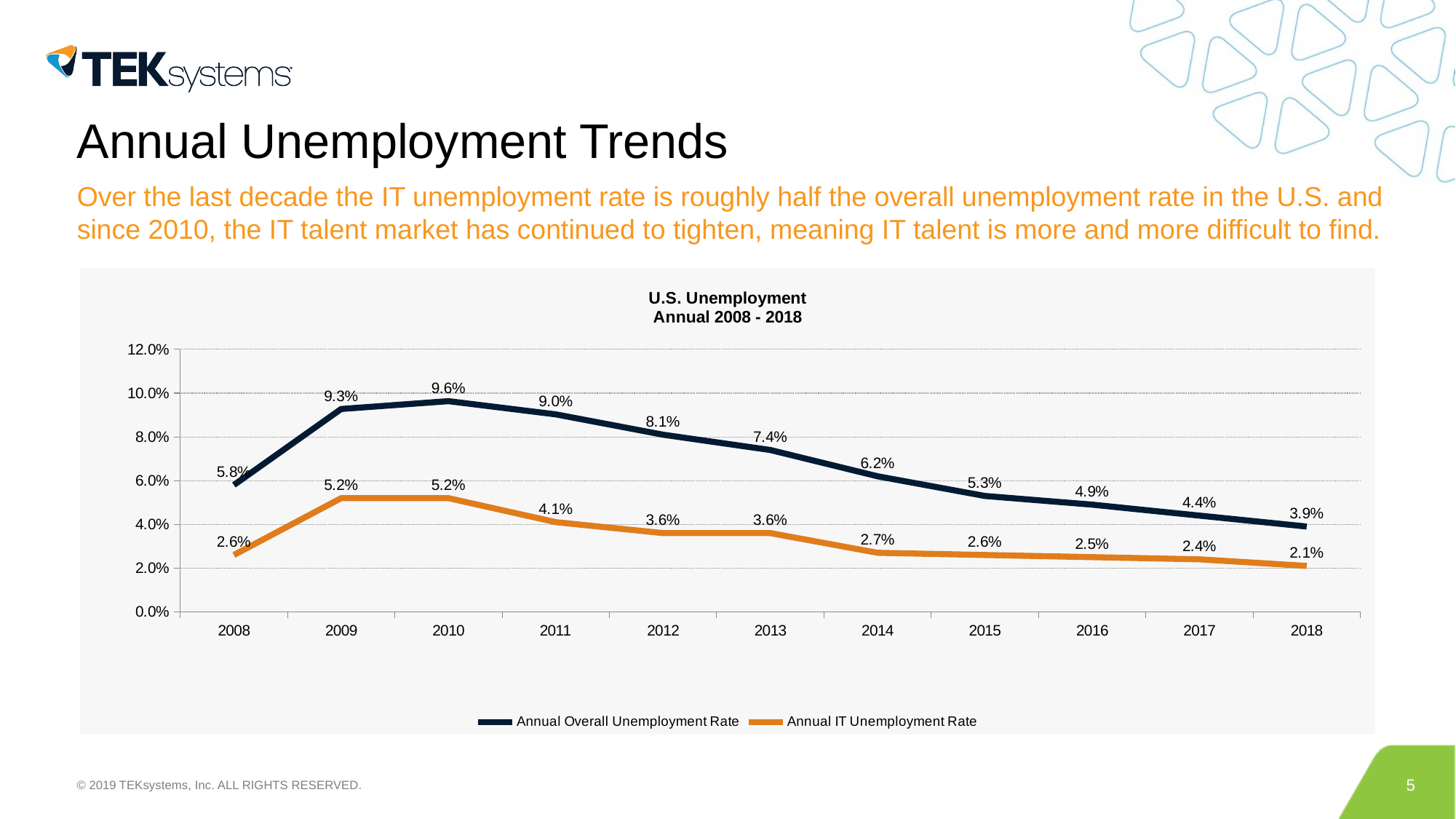
How many years are shown on the x axis of the chart? 11 Which was higher in 2009: the Annual Overall Unemployment Rate or the Annual IT Unemployment Rate? Annual Overall Unemployment Rate How many series does the chart legend list? 2 In which year was the Annual IT Unemployment Rate lowest? 2018 In which year was the Annual Overall Unemployment Rate highest? 2010 What is the title of the chart? U.S. Unemployment Annual 2008 - 2018 What kind of chart is shown on the slide? Line chart From 2010 to 2018, does the Annual Overall Unemployment Rate rise or fall? Fall What was the Annual IT Unemployment Rate in 2014? 2.7% What is the difference between the Annual Overall Unemployment Rate and the Annual IT Unemployment Rate in 2013? 3.8% What was the Annual Overall Unemployment Rate in 2010? 9.6% Is the Annual Overall Unemployment Rate in 2011 greater or less than 8.0%? greater